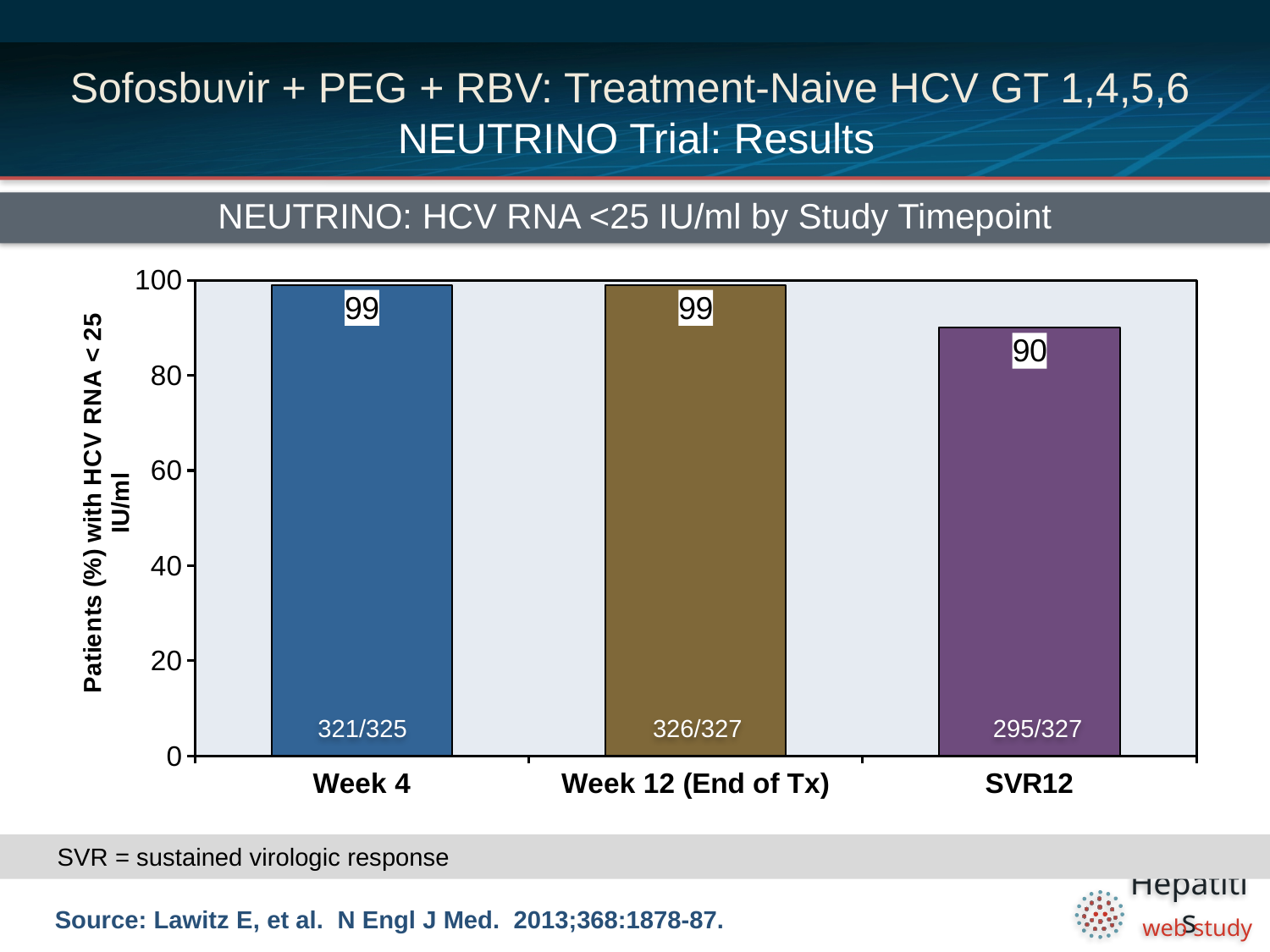
Is the value for SVR12 greater or less than 80? greater What fraction of patients is printed inside the Week 4 bar? 321/325 What is the value for SVR12? 90 What kind of chart is shown on the slide? bar chart How many categories are shown on the x axis? 3 Which category has the lowest value? SVR12 What fraction of patients is printed inside the SVR12 bar? 295/327 What is the value for Week 12 (End of Tx)? 99 Which is larger, the value for Week 12 (End of Tx) or the value for SVR12? Week 12 (End of Tx) What is the difference between the values for Week 4 and SVR12? 9 What is the title of the chart? NEUTRINO: HCV RNA <25 IU/ml by Study Timepoint What is the value for Week 4? 99